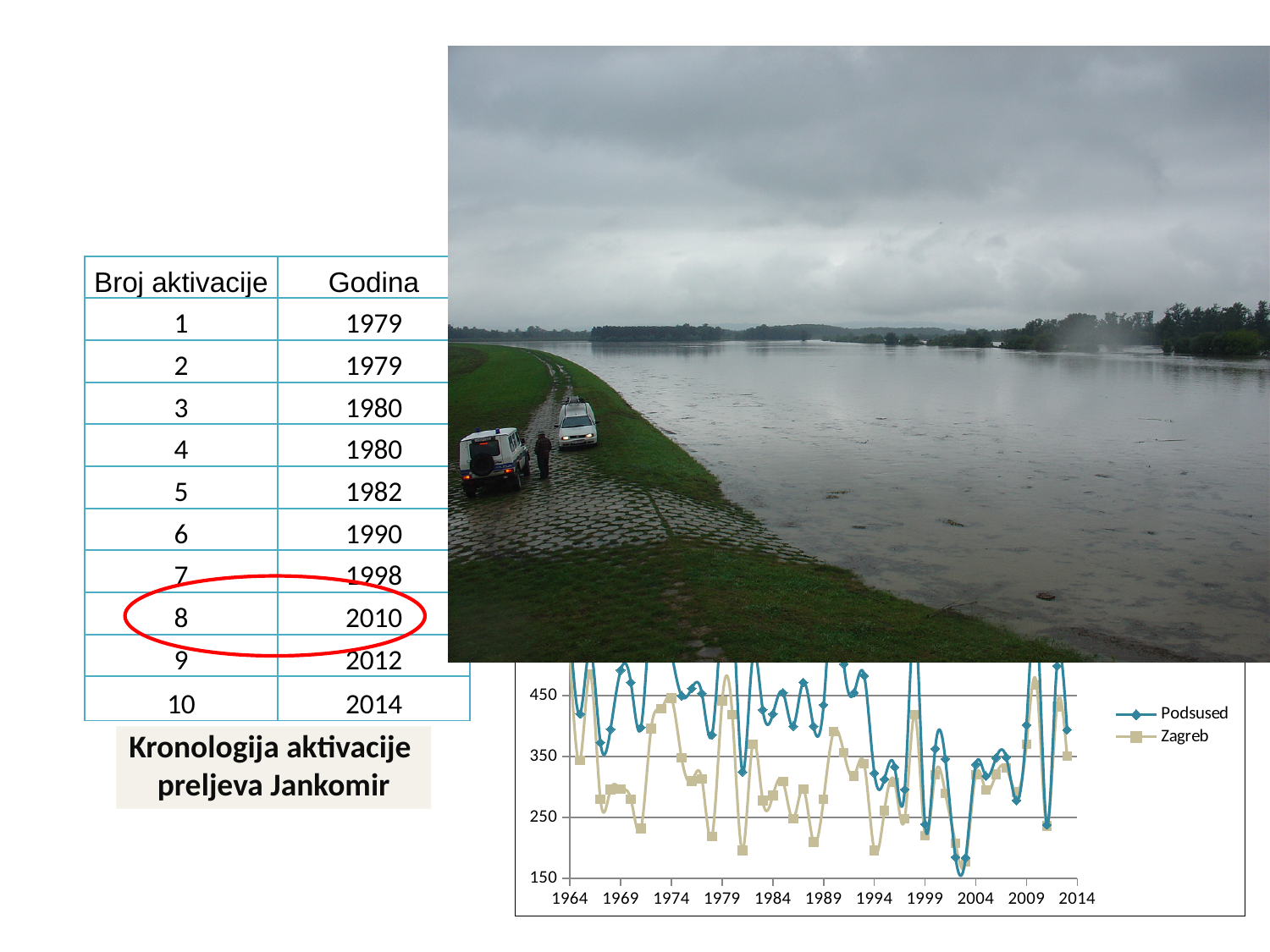
In the line chart, is the value for Podsused around 2003 greater or less than 250? less What kind of chart is shown at the bottom right of the slide? line chart What is the first year labelled on the x axis of the line chart? 1964 In the line chart, which series has the larger value in 1994, Podsused or Zagreb? Podsused In the line chart, is the value for Zagreb in 1981 greater or less than 250? less In the line chart, which series is drawn in blue with diamond markers? Podsused In the line chart, which series has the larger value in 1981, Podsused or Zagreb? Podsused What are the two series named in the legend of the line chart? Podsused and Zagreb How many series does the legend of the line chart list? 2 In the line chart, is the value for Podsused in 1987 greater or less than 350? greater